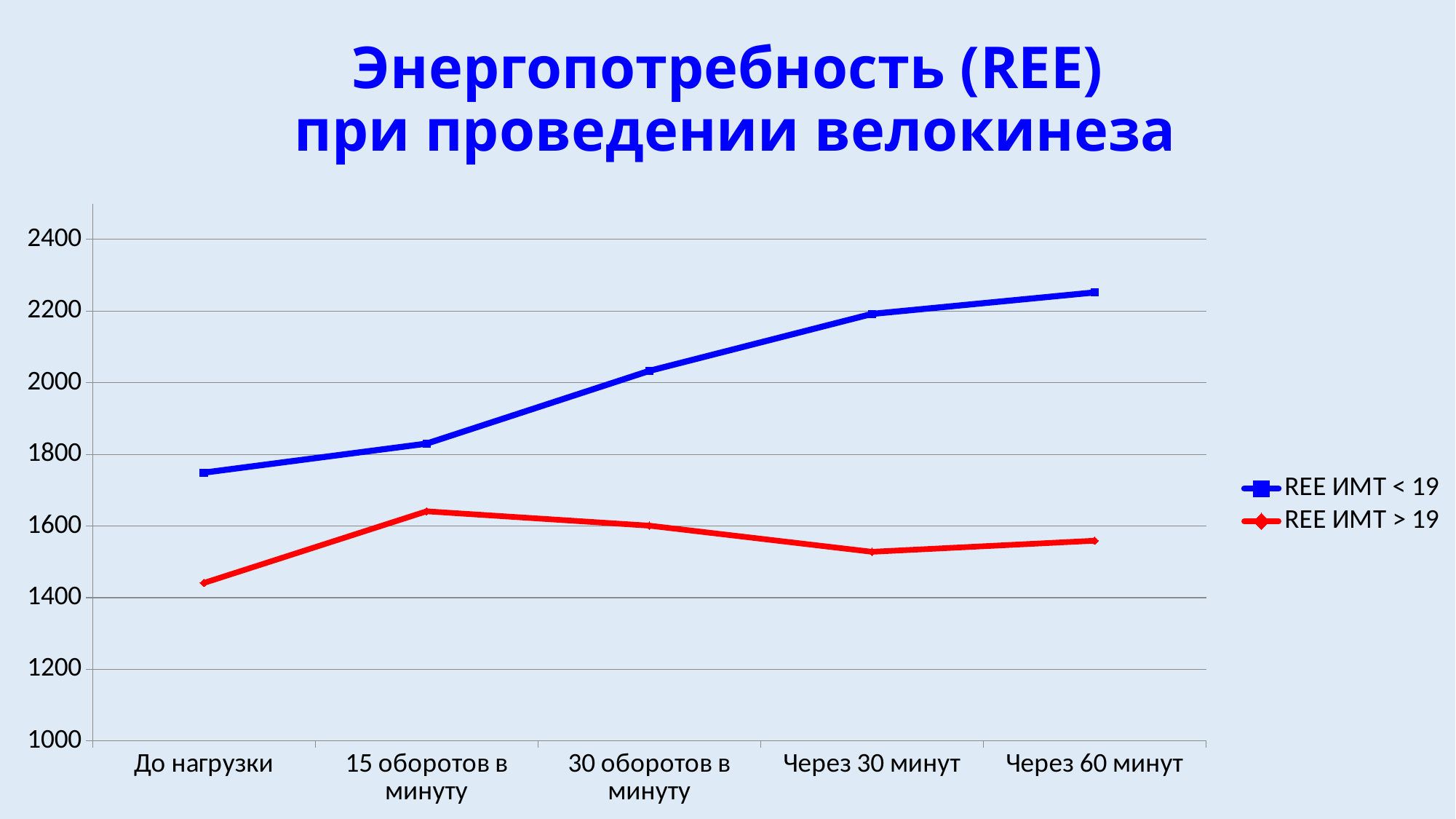
Is the value for REE ИМТ < 19 at "Через 60 минут" greater or less than 2200? greater At which category does the REE ИМТ < 19 series reach its highest value? Через 60 минут Which series has the higher value at "Через 60 минут"? REE ИМТ < 19 Does the REE ИМТ < 19 series rise or fall along the x axis? Rises How many series does the legend list? 2 At which category does the REE ИМТ > 19 series reach its highest value? 15 оборотов в минуту Is the value for REE ИМТ < 19 at "До нагрузки" greater or less than 1800? less Is the value for REE ИМТ > 19 at "15 оборотов в минуту" greater or less than 1600? greater What kind of chart is shown on the slide? Line chart How many categories are shown along the x axis? 5 At which category is the REE ИМТ > 19 series lowest? До нагрузки